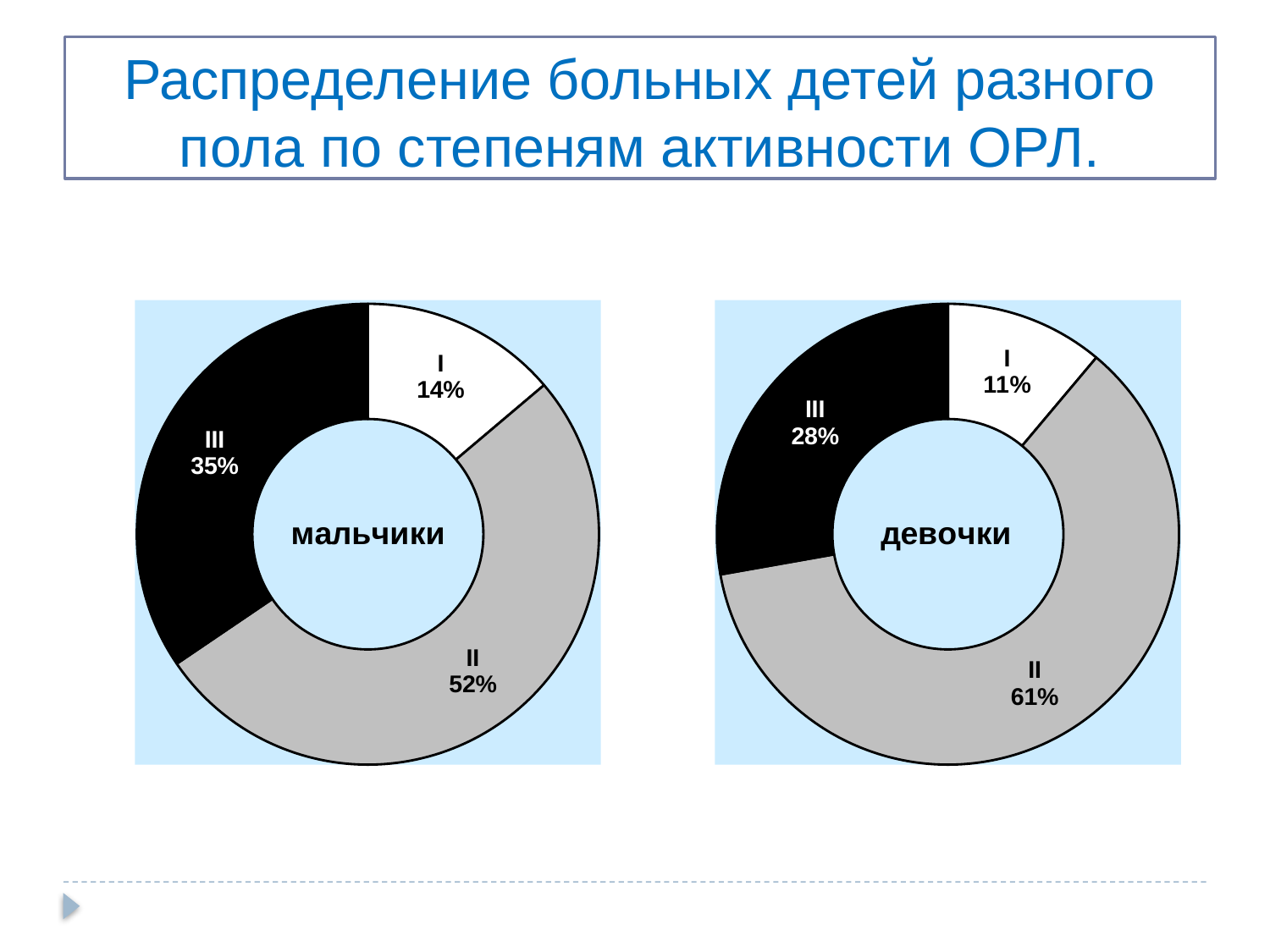
How many segments does the "девочки" chart have? 3 Which is larger: the share of degree III in the "мальчики" chart or in the "девочки" chart? мальчики In the "мальчики" chart, which degree has the smallest share? I In the "мальчики" chart, what percentage is shown for degree I? 14% In the "мальчики" chart, what is the difference between the shares of degree III and degree I? 21% In the "девочки" chart, what is the difference between the shares of degree II and degree III? 33% In the "мальчики" chart, what percentage is shown for degree II? 52% In the "девочки" chart, what colour is the segment for degree II? Grey What type of chart is the "мальчики" chart? Pie chart (doughnut) In the "девочки" chart, what percentage is shown for degree III? 28% In the "девочки" chart, which degree has the largest share? II What is the title of the slide? Распределение больных детей разного пола по степеням активности ОРЛ.